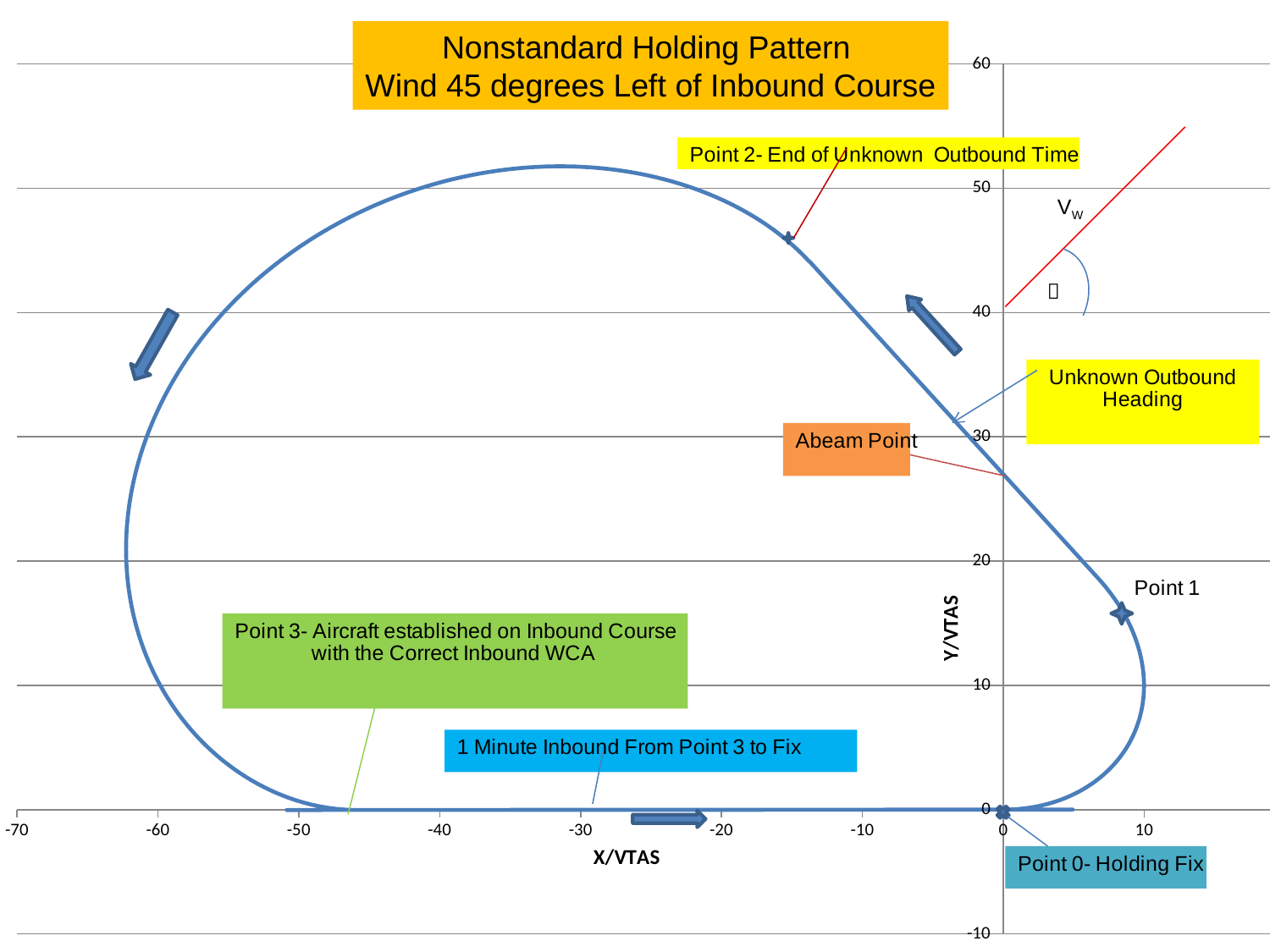
Is the highest Y/VTAS value reached by the holding pattern greater or less than 50? greater How many numbered points (Point 0 through Point 3) are labeled on the holding pattern? 4 Is the Y/VTAS value at Point 2 greater or less than 40? greater Is the X/VTAS value at Point 3 greater or less than -40? less What is the label of the horizontal axis? X/VTAS What kind of chart is shown on the slide? line chart What is the title of the chart? Nonstandard Holding Pattern Wind 45 degrees Left of Inbound Course What is the Y/VTAS value at Point 3, where the aircraft is established on the inbound course? 0 What is the Y/VTAS value at Point 0, the Holding Fix? 0 What is the X/VTAS value at Point 0, the Holding Fix? 0